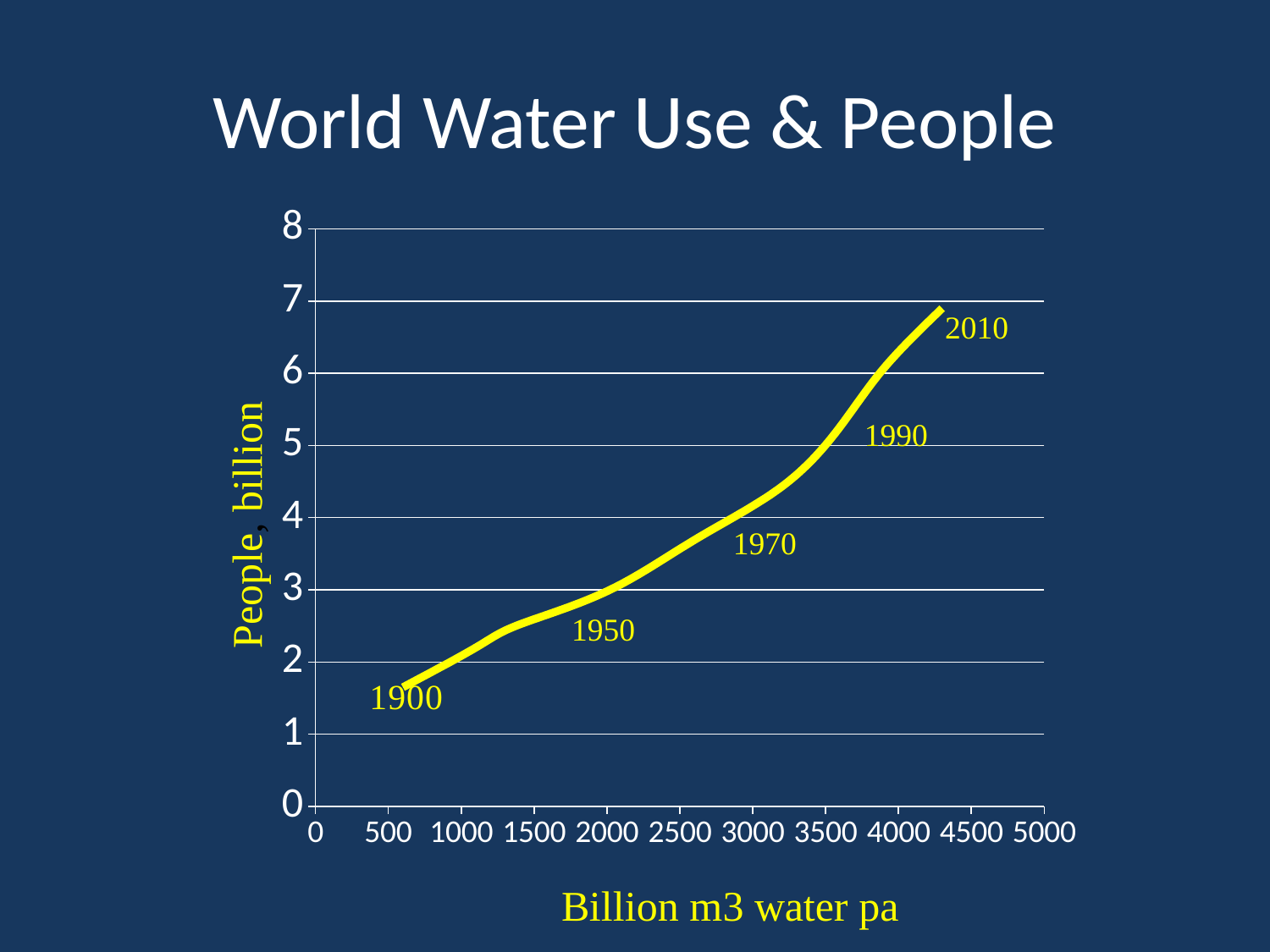
Is the water use (billion m3 pa) at the 1990 point greater or less than 3000? greater Is the number of people (billion) at the 1900 point greater or less than 2? less What is the title of the chart? World Water Use & People What is the label of the vertical axis? People, billion What kind of chart is shown on the slide? line chart Is the number of people (billion) at the 1970 point greater or less than 3? greater As water use increases along the x axis, does the number of people rise or fall? rise How many labelled year points are marked on the line? 5 Which labelled year point has the highest number of people? 2010